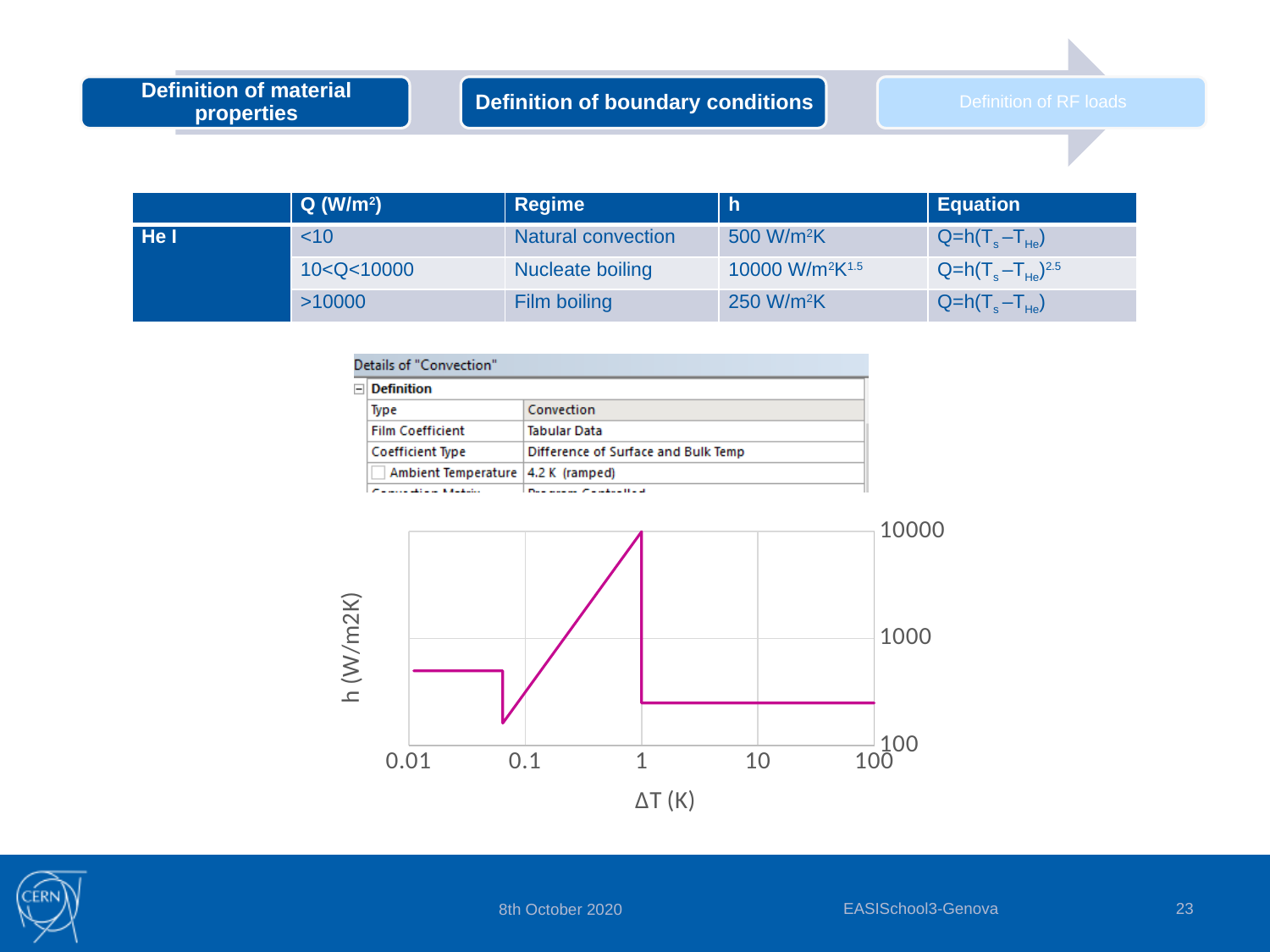
What is the label of the x axis of the chart? ΔT (K) Between ΔT = 10 K and ΔT = 100 K, does h rise, fall or stay flat? stay flat At which ΔT value does h reach its maximum on the chart? 1 How many tick labels are shown on the x axis of the chart? 5 Is the value of h at ΔT = 0.01 K greater or less than 1000? less Is the peak value of h on the chart greater or less than 1000? greater Is the value of h at ΔT = 10 K greater or less than 1000? less What is the label of the y axis of the chart? h (W/m2K) Between ΔT = 0.1 K and ΔT = 1 K, does h rise or fall? rise How many tick labels are shown on the y axis of the chart? 3 What kind of chart is shown on the slide? line chart